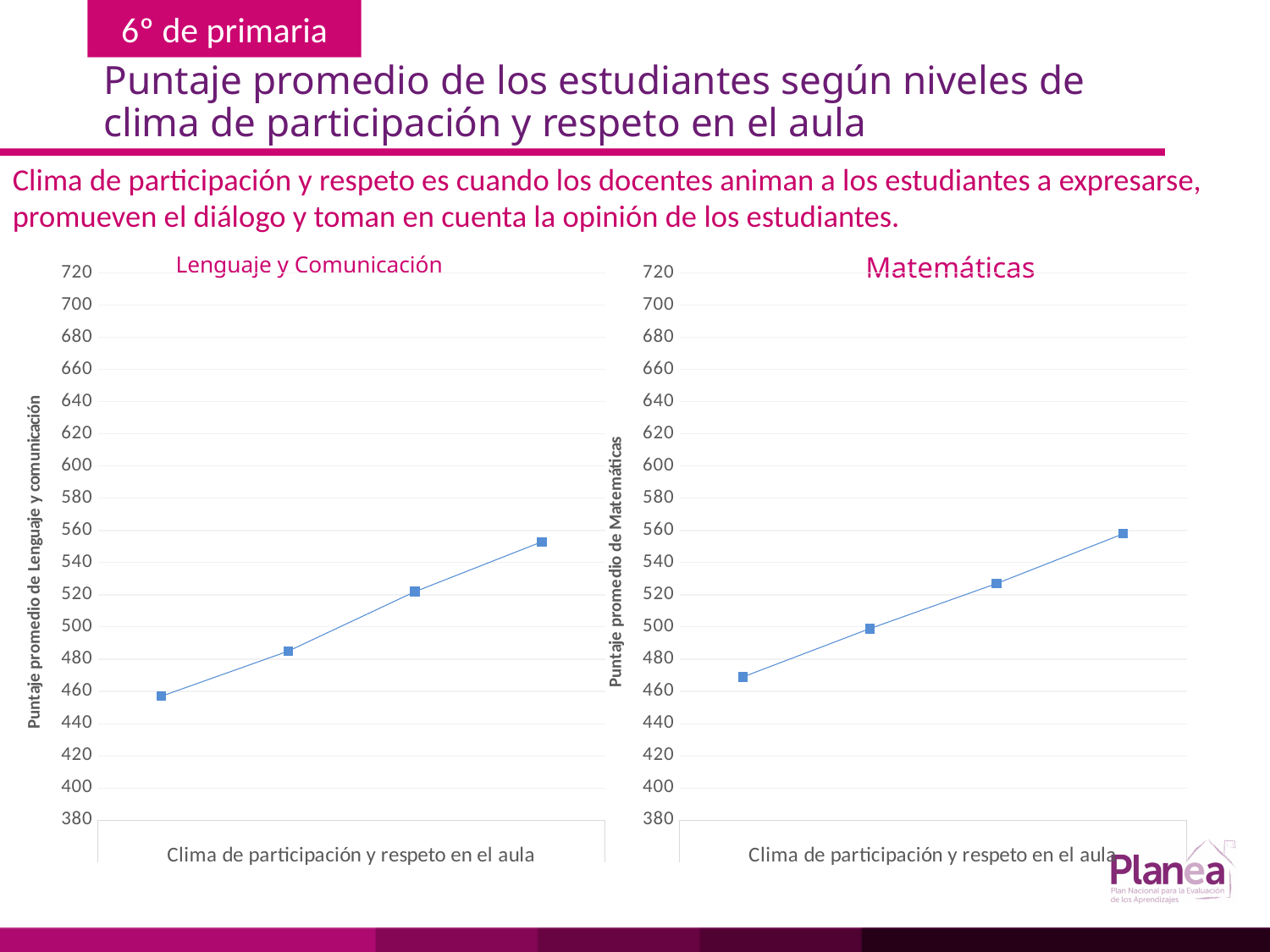
On the Lenguaje y Comunicación chart, is the value of the leftmost point greater or less than 480? less What kind of chart is the Matemáticas chart? line chart What kind of chart is the Lenguaje y Comunicación chart? line chart What is the title of the chart on the right side of the slide? Matemáticas What is the x-axis label on the Lenguaje y Comunicación chart? Clima de participación y respeto en el aula On the Lenguaje y Comunicación chart, is the value of the rightmost point greater or less than 540? greater On the Matemáticas chart, do the values rise or fall from left to right? rise On the Matemáticas chart, is the value of the rightmost point greater or less than 540? greater On the Lenguaje y Comunicación chart, do the values rise or fall from left to right? rise How many data points are plotted on the Lenguaje y Comunicación chart? 4 How many data points are plotted on the Matemáticas chart? 4